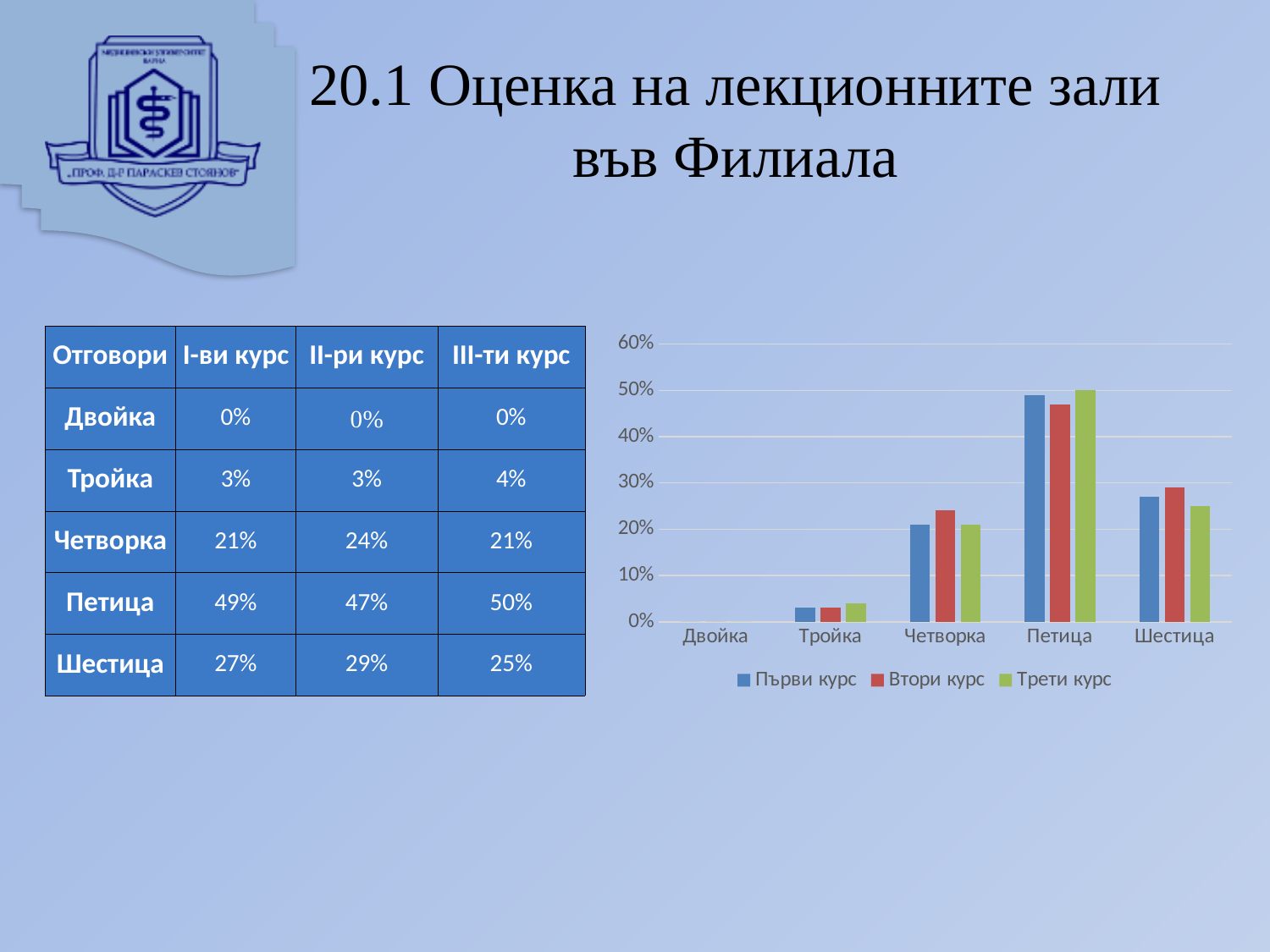
How many series does the chart legend list? 3 According to the table, what is the value for Четворка in II-ри курс? 24% According to the table, what is the value for Петица in I-ви курс? 49% Using the table values, what is the difference between Петица and Шестица for III-ти курс? 25% Which category has the highest value for Първи курс in the chart? Петица What kind of chart is shown on the slide? bar chart In the chart, which is larger for Шестица: Втори курс or Трети курс? Втори курс How many categories are shown on the x axis of the chart? 5 What colour are the bars for the Втори курс series in the chart? red Is the value for Четворка in the Първи курс series greater or less than 30%? less Which category has the lowest value for Трети курс in the chart? Двойка Is the value for Петица in the Трети курс series greater or less than 40%? greater